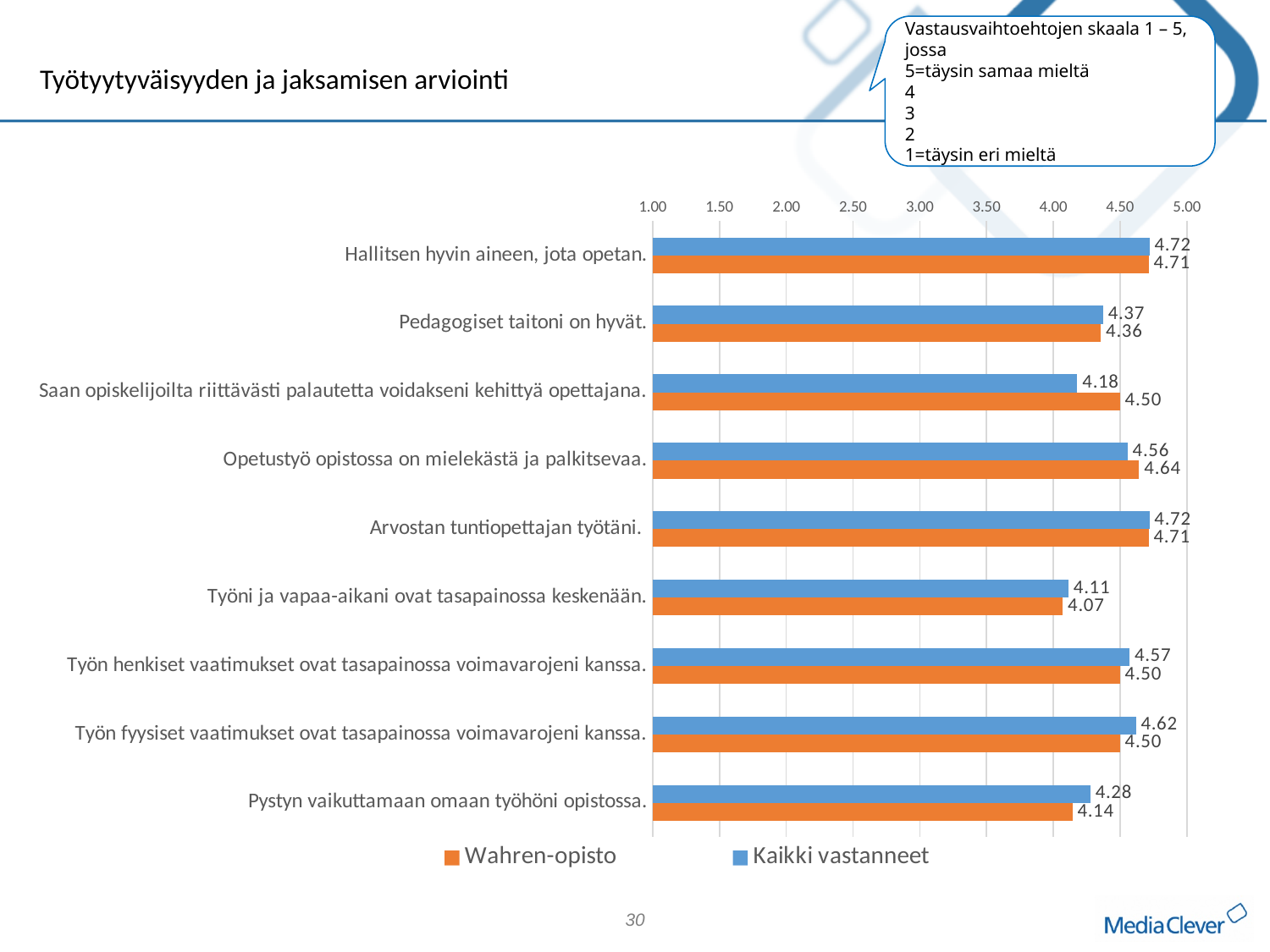
What is the value for Wahren-opisto on "Saan opiskelijoilta riittävästi palautetta voidakseni kehittyä opettajana."? 4.50 What is the difference between Kaikki vastanneet and Wahren-opisto on "Pystyn vaikuttamaan omaan työhöni opistossa."? 0.14 Which statement has the lowest value for Wahren-opisto? Työni ja vapaa-aikani ovat tasapainossa keskenään. How many series does the legend list? 2 What is the value for Kaikki vastanneet on "Pystyn vaikuttamaan omaan työhöni opistossa."? 4.28 What is the value for Wahren-opisto on "Opetustyö opistossa on mielekästä ja palkitsevaa."? 4.64 How many statements are shown on the chart? 9 Which statement has the lowest value for Kaikki vastanneet? Työni ja vapaa-aikani ovat tasapainossa keskenään. What is the difference between Wahren-opisto and Kaikki vastanneet on "Saan opiskelijoilta riittävästi palautetta voidakseni kehittyä opettajana."? 0.32 Is the value for Wahren-opisto on "Työni ja vapaa-aikani ovat tasapainossa keskenään." greater or less than 4.00? greater On "Työn fyysiset vaatimukset ovat tasapainossa voimavarojeni kanssa.", which series has the larger value, Wahren-opisto or Kaikki vastanneet? Kaikki vastanneet What kind of chart is shown on the slide? bar chart